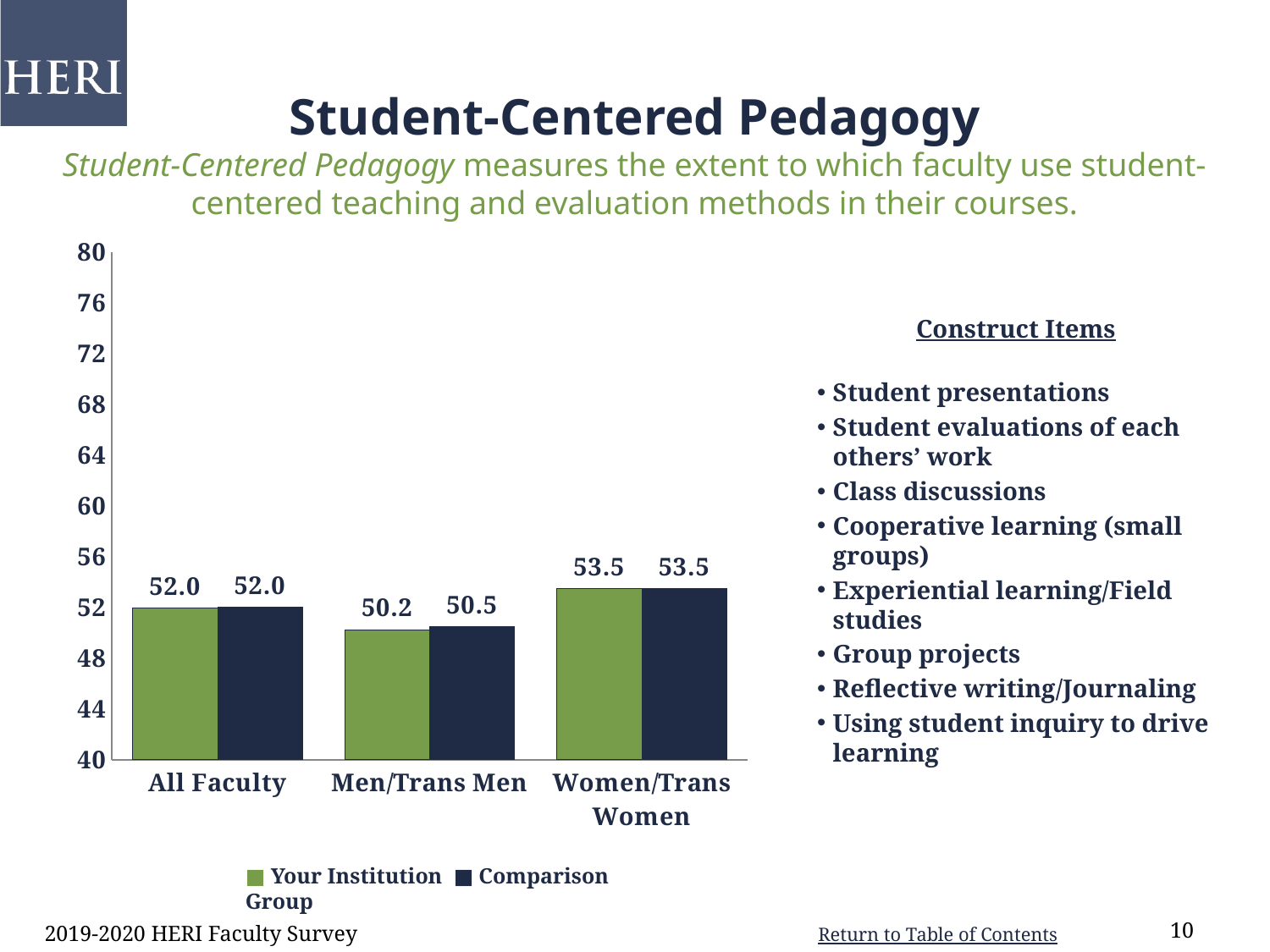
What is the value for Your Institution in the All Faculty category? 52.0 Which is larger for Your Institution: All Faculty or Men/Trans Men? All Faculty Which category has the highest value for Your Institution? Women/Trans Women Which category has the lowest value for Comparison Group? Men/Trans Men What is the value for Comparison Group in the Men/Trans Men category? 50.5 What is the difference between the Comparison Group value and the Your Institution value for Men/Trans Men? 0.3 What is the value for Your Institution in the Women/Trans Women category? 53.5 How many categories are shown on the x axis? 3 What kind of chart is shown on the slide? bar chart How many series does the legend list? 2 Is the Comparison Group value for Women/Trans Women greater or less than 52? greater What is the difference between the Your Institution values for Women/Trans Women and All Faculty? 1.5